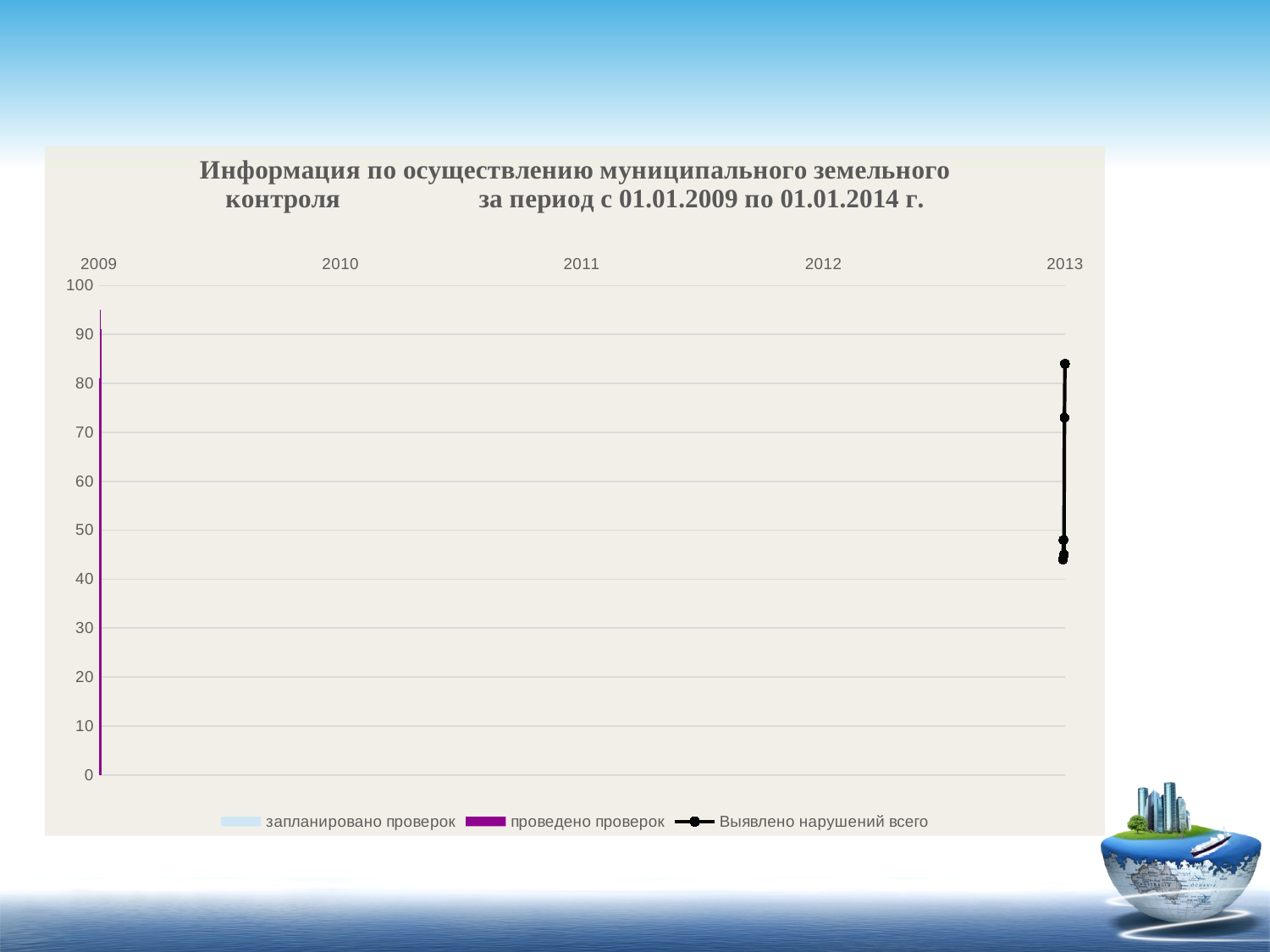
What is the highest value shown on the vertical axis? 100 What is the first year shown on the x axis? 2009 What is the last year shown on the x axis? 2013 How many series does the legend list? 3 How many year categories are shown along the x axis? 5 Which series in the legend is drawn as a black line with markers? Выявлено нарушений всего What period does the chart title say the data covers? с 01.01.2009 по 01.01.2014 г.